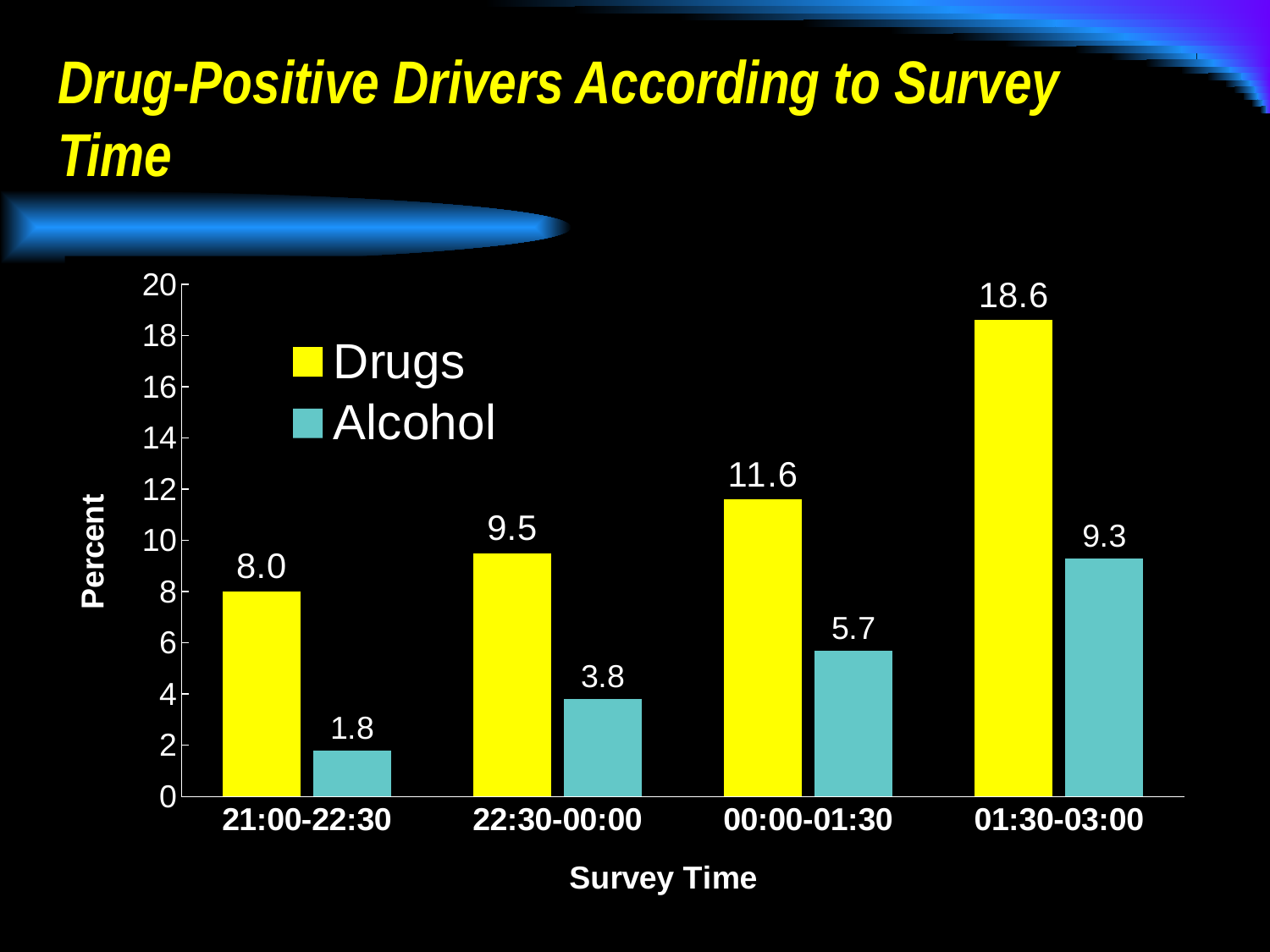
What is the Alcohol value for the 00:00-01:30 survey time? 5.7 Which survey time has the lowest Alcohol value? 21:00-22:30 How many survey time categories are shown on the x axis? 4 What kind of chart is shown on the slide? Bar chart What is the Alcohol value for the 01:30-03:00 survey time? 9.3 Is the Drugs value for 01:30-03:00 greater or less than 16? greater Which is larger: the Drugs value for 00:00-01:30 or the Alcohol value for 01:30-03:00? Drugs value for 00:00-01:30 Do the Alcohol values rise or fall across the survey times from left to right? Rise What is the Drugs value for the 21:00-22:30 survey time? 8.0 What is the difference between the Drugs and Alcohol values for the 22:30-00:00 survey time? 5.7 How many series does the legend list? 2 Which survey time has the highest Drugs value? 01:30-03:00